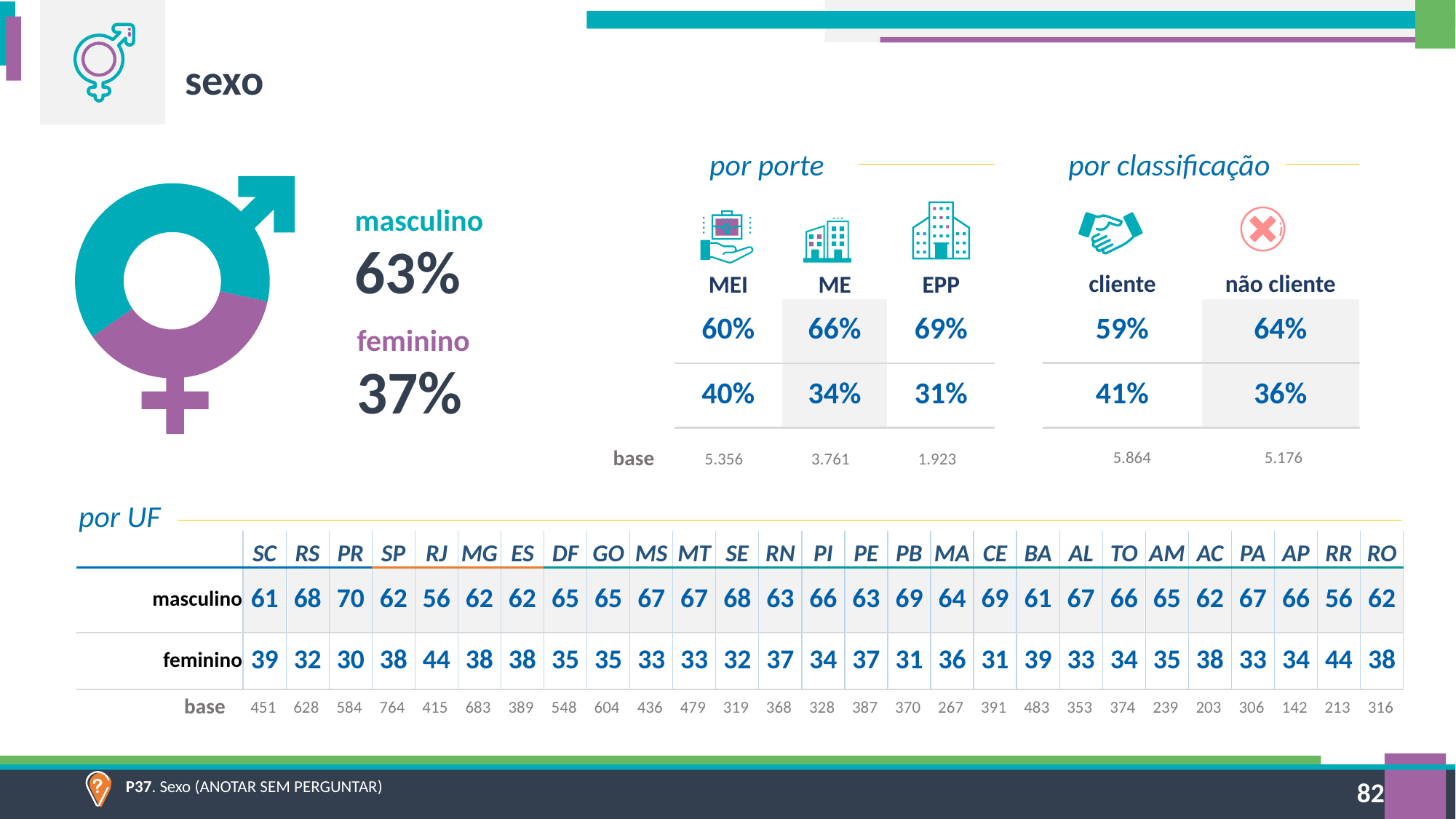
Which category has the larger share in the donut chart, masculino or feminino? masculino Is the masculino share in the donut chart greater or less than 50%? greater Which category has the smallest share in the donut chart? feminino How many categories does the donut chart show? 2 Do the masculino and feminino shares in the donut chart add up to 100%? yes What colour represents feminino in the donut chart? purple What kind of chart is used to show the masculino and feminino shares? donut chart What colour represents masculino in the donut chart? teal What is the difference in percentage points between the masculino and feminino shares in the donut chart? 26 What share of the donut chart is labelled masculino? 63% What share of the donut chart is labelled feminino? 37%